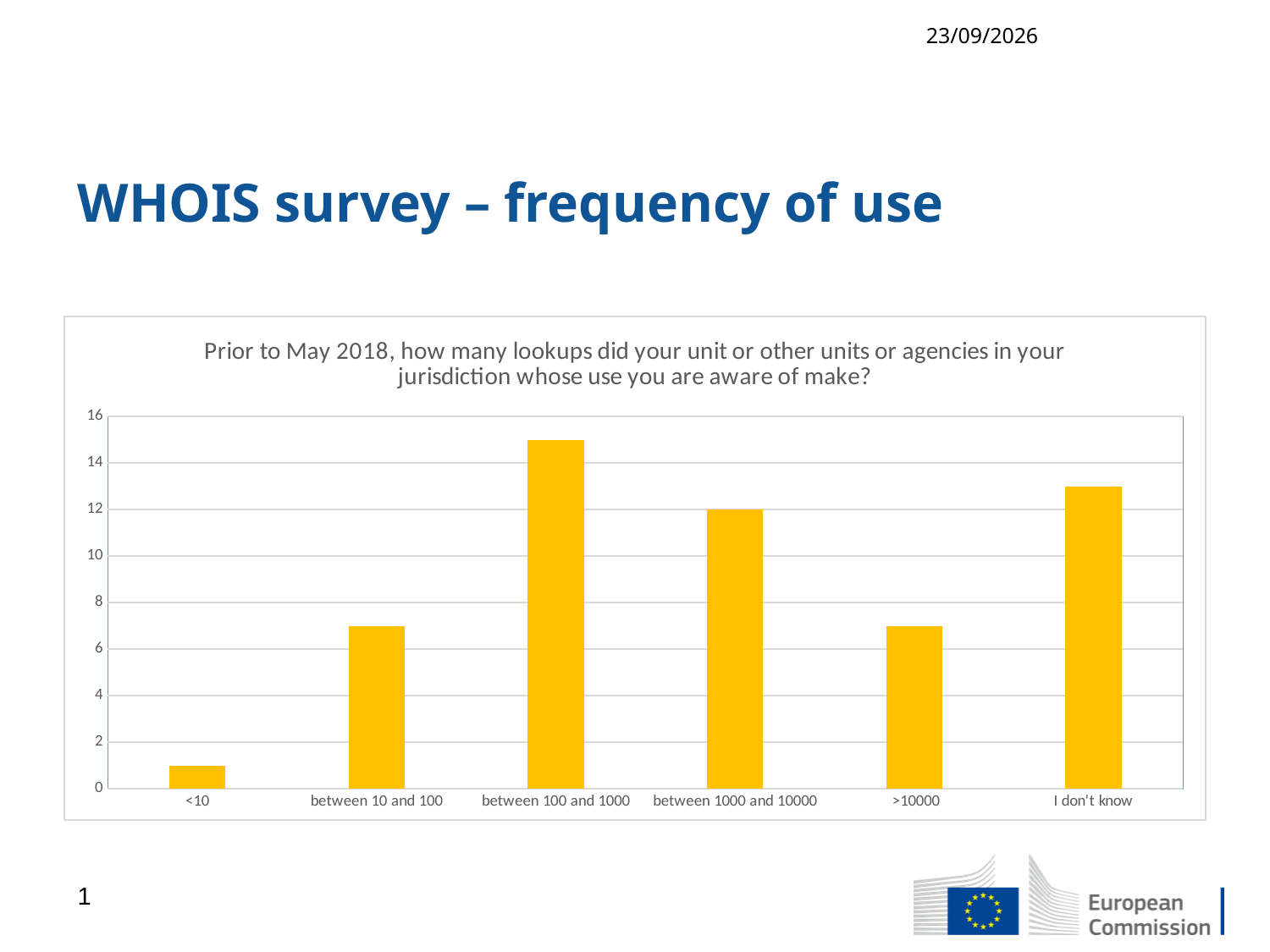
Which is larger, the value for 'between 100 and 1000' or the value for 'I don't know'? between 100 and 1000 Is the value for 'I don't know' greater or less than 12? greater Is the value for '<10' greater or less than 2? less Which is larger, the value for 'between 10 and 100' or the value for 'between 1000 and 10000'? between 1000 and 10000 What colour are the bars in the chart? yellow What is the value for 'between 1000 and 10000'? 12 Which category has the highest value in the chart? between 100 and 1000 Is the value for 'between 100 and 1000' greater or less than 14? greater Which category has the lowest value in the chart? <10 How many categories are shown on the x axis of the chart? 6 What type of chart is shown on the slide? bar chart